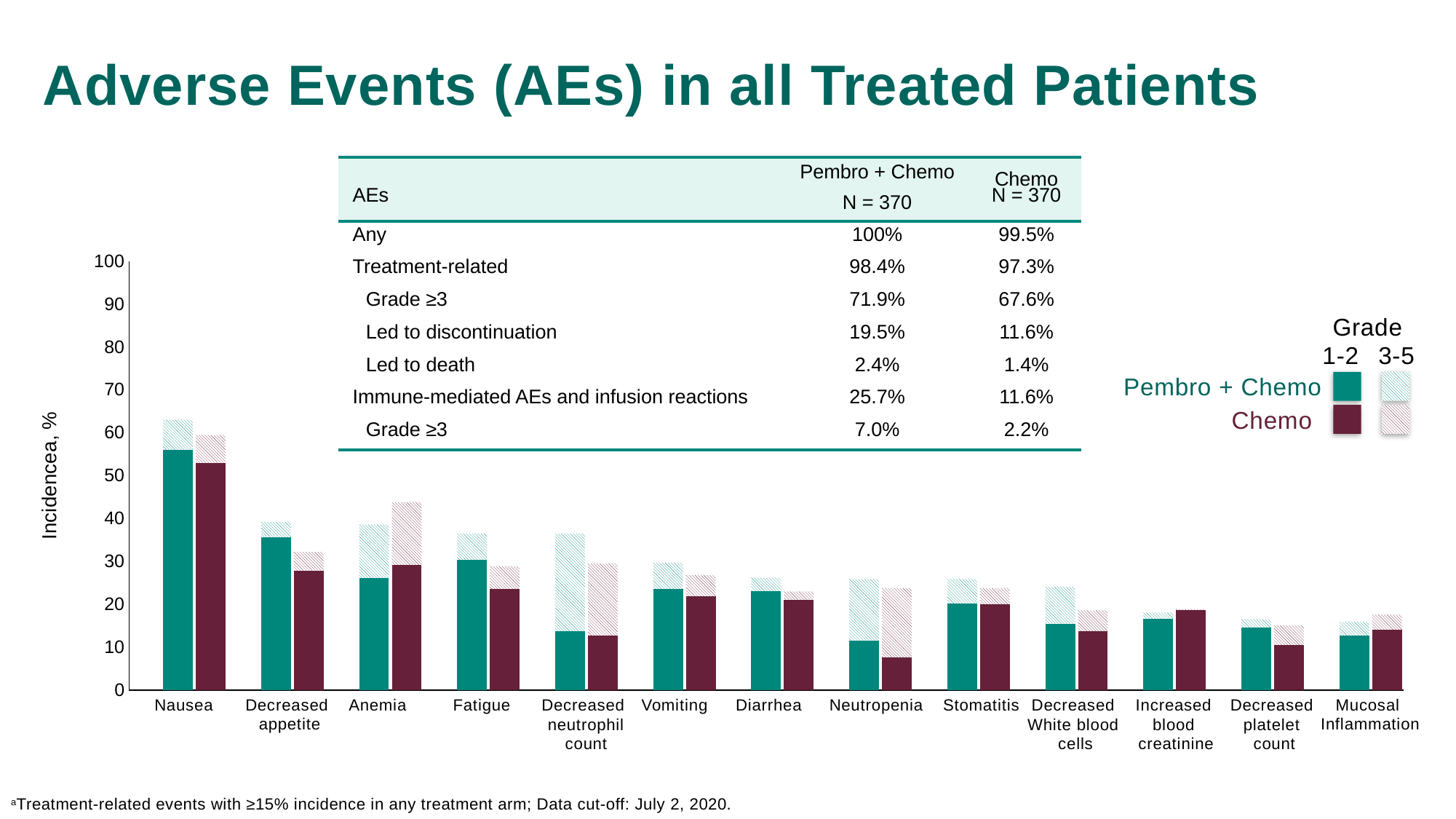
Is the total incidence of Nausea for Pembro + Chemo greater or less than 60? greater For Decreased neutrophil count, which arm has the higher total incidence, Pembro + Chemo or Chemo? Pembro + Chemo Is the total incidence of Anemia for Chemo greater or less than 40? greater For Anemia, which arm has the higher total incidence, Pembro + Chemo or Chemo? Chemo How many treatment arms does the chart legend list? 2 What is the label of the y axis of the chart? Incidence, % What kind of chart is shown on the slide? bar chart Is the total incidence of Decreased neutrophil count for Pembro + Chemo greater or less than 30? greater Which adverse event has the lowest grade 1-2 incidence for Chemo in the chart? Neutropenia Which adverse event has the highest incidence for Pembro + Chemo in the chart? Nausea How many adverse event categories are shown along the x axis of the chart? 13